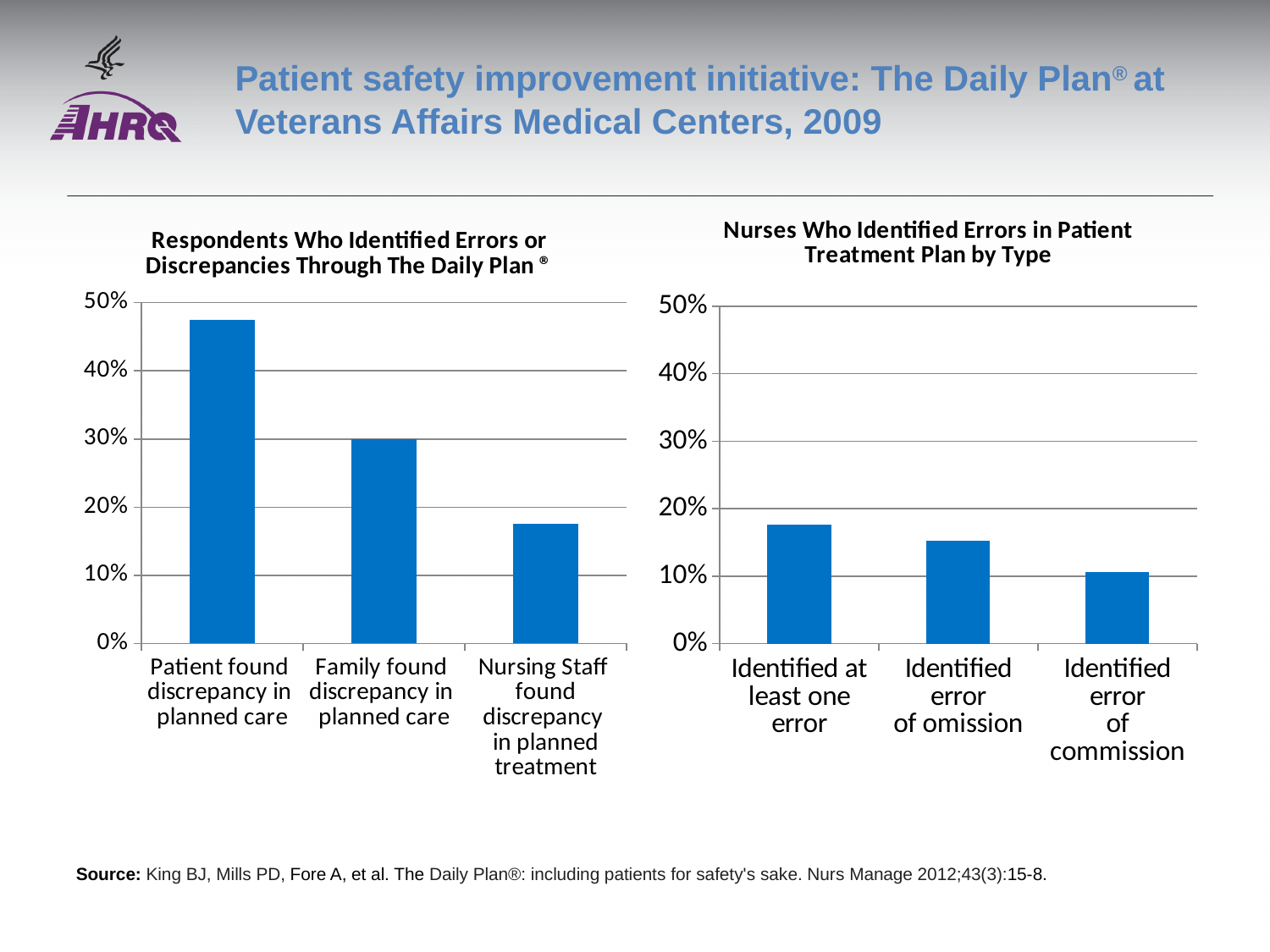
In the left chart, 'Respondents Who Identified Errors or Discrepancies Through The Daily Plan', is the value for 'Nursing Staff found discrepancy in planned treatment' greater or less than 20%? less How many categories are shown in the left chart, 'Respondents Who Identified Errors or Discrepancies Through The Daily Plan'? 3 What is the highest value shown on the vertical axis of the right chart, 'Nurses Who Identified Errors in Patient Treatment Plan by Type'? 50% In the right chart, 'Nurses Who Identified Errors in Patient Treatment Plan by Type', which is larger: 'Identified error of omission' or 'Identified error of commission'? Identified error of omission In the right chart, 'Nurses Who Identified Errors in Patient Treatment Plan by Type', which category has the highest value? Identified at least one error In the left chart, 'Respondents Who Identified Errors or Discrepancies Through The Daily Plan', do the values rise or fall from left to right? fall In the left chart, 'Respondents Who Identified Errors or Discrepancies Through The Daily Plan', is the value for 'Patient found discrepancy in planned care' greater or less than 40%? greater In the right chart, 'Nurses Who Identified Errors in Patient Treatment Plan by Type', which category has the lowest value? Identified error of commission In the left chart, 'Respondents Who Identified Errors or Discrepancies Through The Daily Plan', which category has the lowest value? Nursing Staff found discrepancy in planned treatment In the right chart, 'Nurses Who Identified Errors in Patient Treatment Plan by Type', is the value for 'Identified error of omission' greater or less than 20%? less In the left chart, 'Respondents Who Identified Errors or Discrepancies Through The Daily Plan', which category has the highest value? Patient found discrepancy in planned care What kind of chart is the left chart, 'Respondents Who Identified Errors or Discrepancies Through The Daily Plan'? bar chart